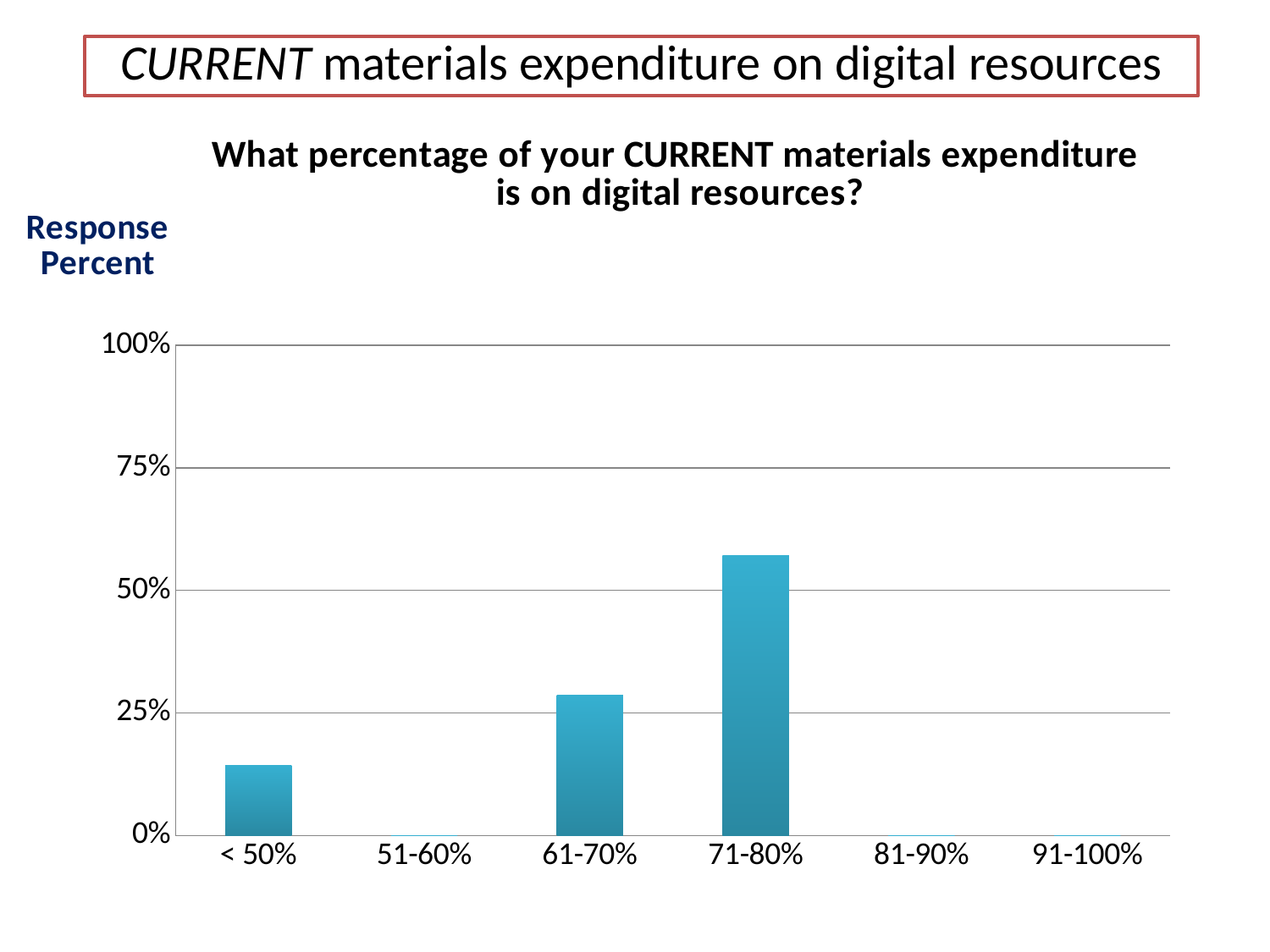
Is the value for 71-80% greater or less than 75%? less How many categories are shown on the x axis of the chart? 6 What is the title of the chart? What percentage of your CURRENT materials expenditure is on digital resources? Which category has the highest response percent? 71-80% Is the value for < 50% greater or less than 25%? less Is the value for 71-80% greater or less than 50%? greater Which is larger, the value for < 50% or the value for 61-70%? 61-70% What is the label of the vertical axis? Response Percent What kind of chart is shown on the slide? bar chart Which is larger, the value for 61-70% or the value for 71-80%? 71-80%